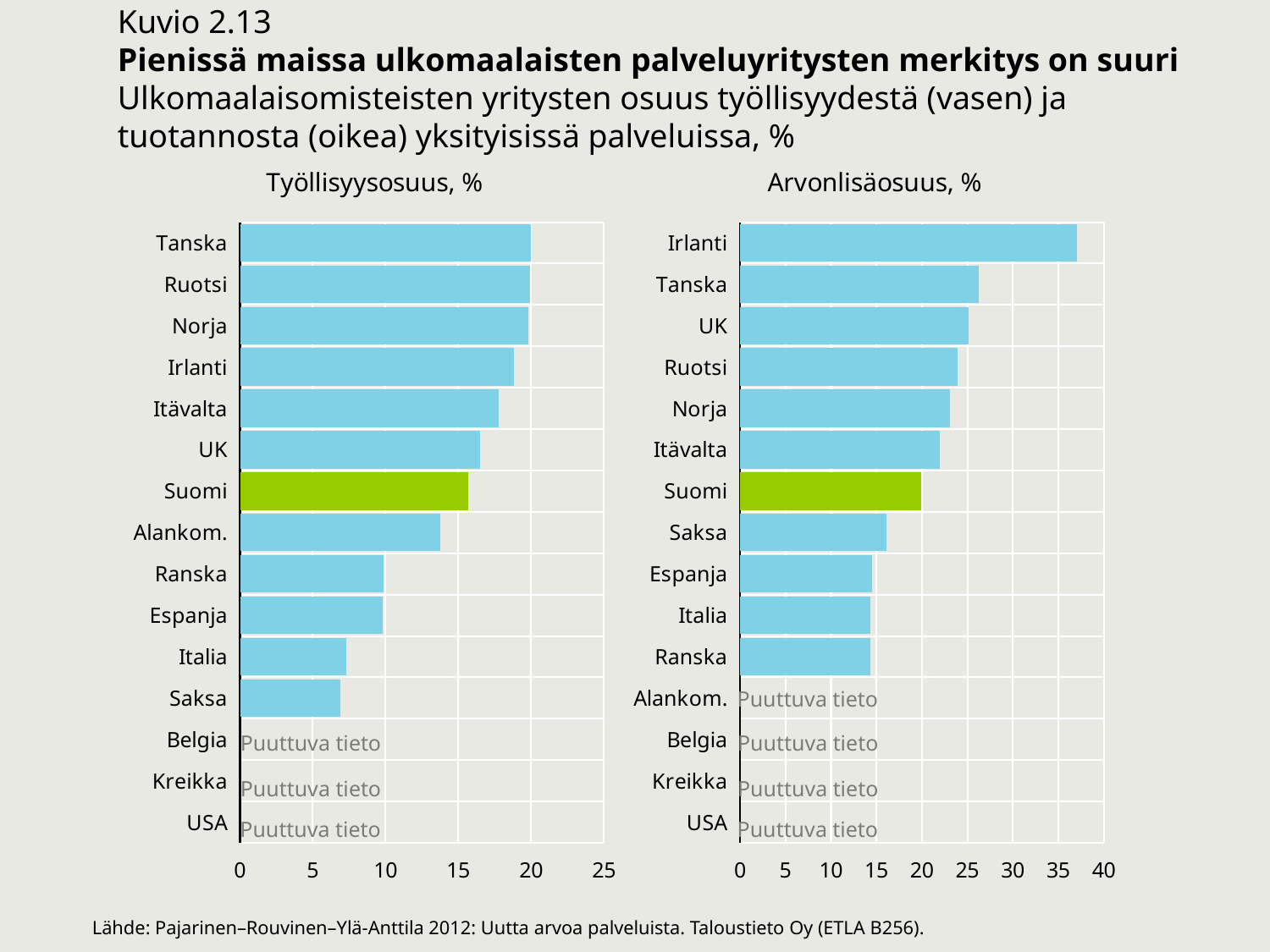
In the right chart "Arvonlisäosuus, %", how many countries are marked "Puuttuva tieto"? 4 In the left chart "Työllisyysosuus, %", is the value for Alankom. greater or less than 15? less In the right chart "Arvonlisäosuus, %", is the value for Suomi greater or less than 25? less In the left chart "Työllisyysosuus, %", how many countries are marked "Puuttuva tieto"? 3 In the left chart "Työllisyysosuus, %", which is larger, the value for Irlanti or the value for Alankom.? Irlanti What kind of chart is the left chart titled "Työllisyysosuus, %"? bar chart In the left chart "Työllisyysosuus, %", is the value for Saksa greater or less than 10? less In the right chart "Arvonlisäosuus, %", which country has the highest value? Irlanti In the right chart "Arvonlisäosuus, %", which is larger, the value for Irlanti or the value for Tanska? Irlanti In the left chart "Työllisyysosuus, %", which country's bar is coloured green instead of blue? Suomi